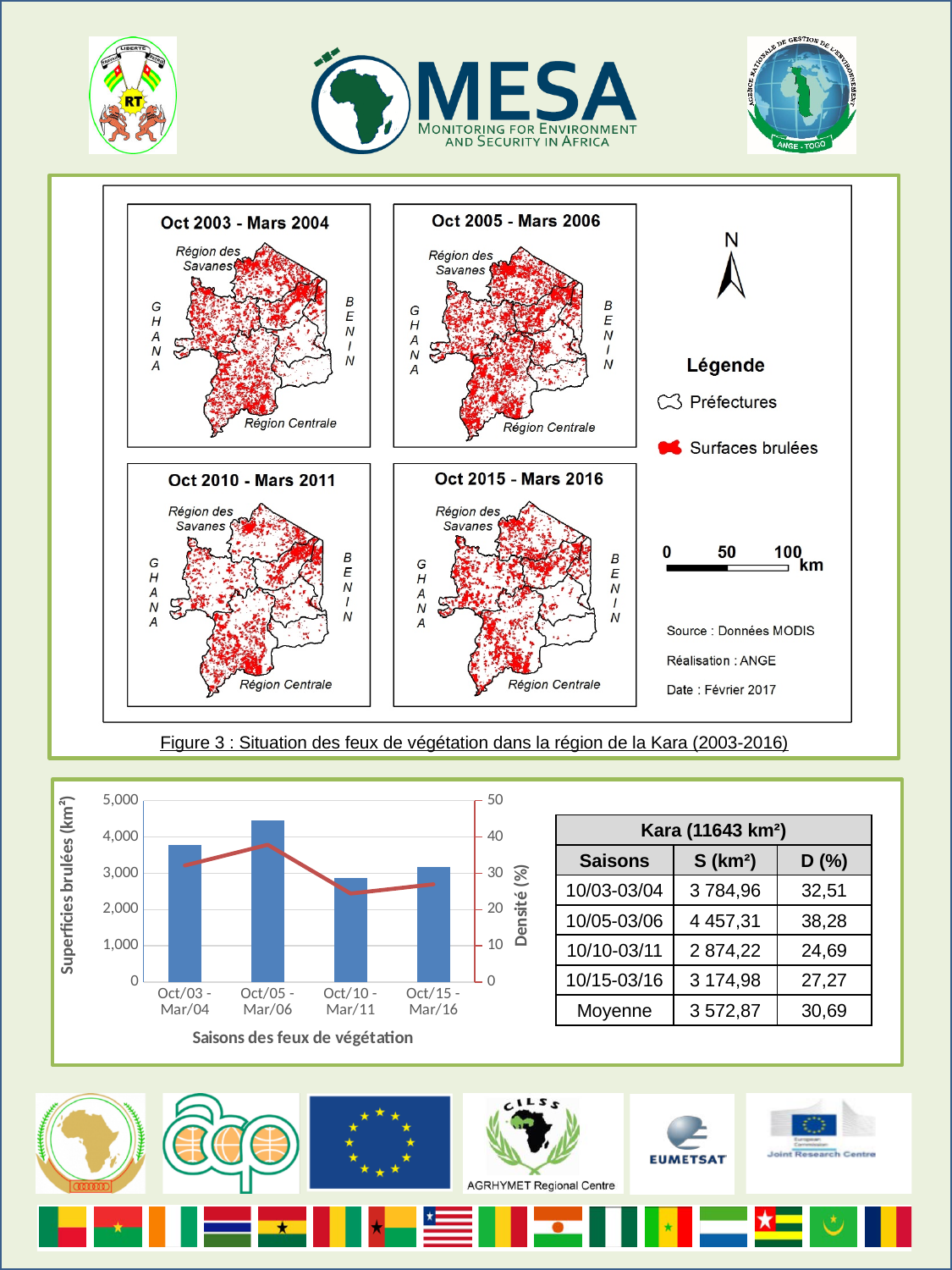
Which season has the tallest bar for burned area (Superficies brulées)? Oct/05 - Mar/06 Does the burned area rise or fall from Oct/05 - Mar/06 to Oct/10 - Mar/11? fall What kind of chart is shown at the bottom of the slide? bar chart with a line At which season does the density (Densité) line reach its highest point? Oct/05 - Mar/06 What is the label of the left vertical axis of the chart? Superficies brulées (km²) Is the burned area bar for Oct/10 - Mar/11 greater or less than 3,000? less Is the density (Densité) line value for Oct/10 - Mar/11 greater or less than 30? less How many fire seasons are plotted on the x axis of the chart? 4 Which bar is taller: Oct/03 - Mar/04 or Oct/15 - Mar/16? Oct/03 - Mar/04 Is the burned area bar for Oct/05 - Mar/06 greater or less than 4,000? greater Which season has the shortest bar for burned area (Superficies brulées)? Oct/10 - Mar/11